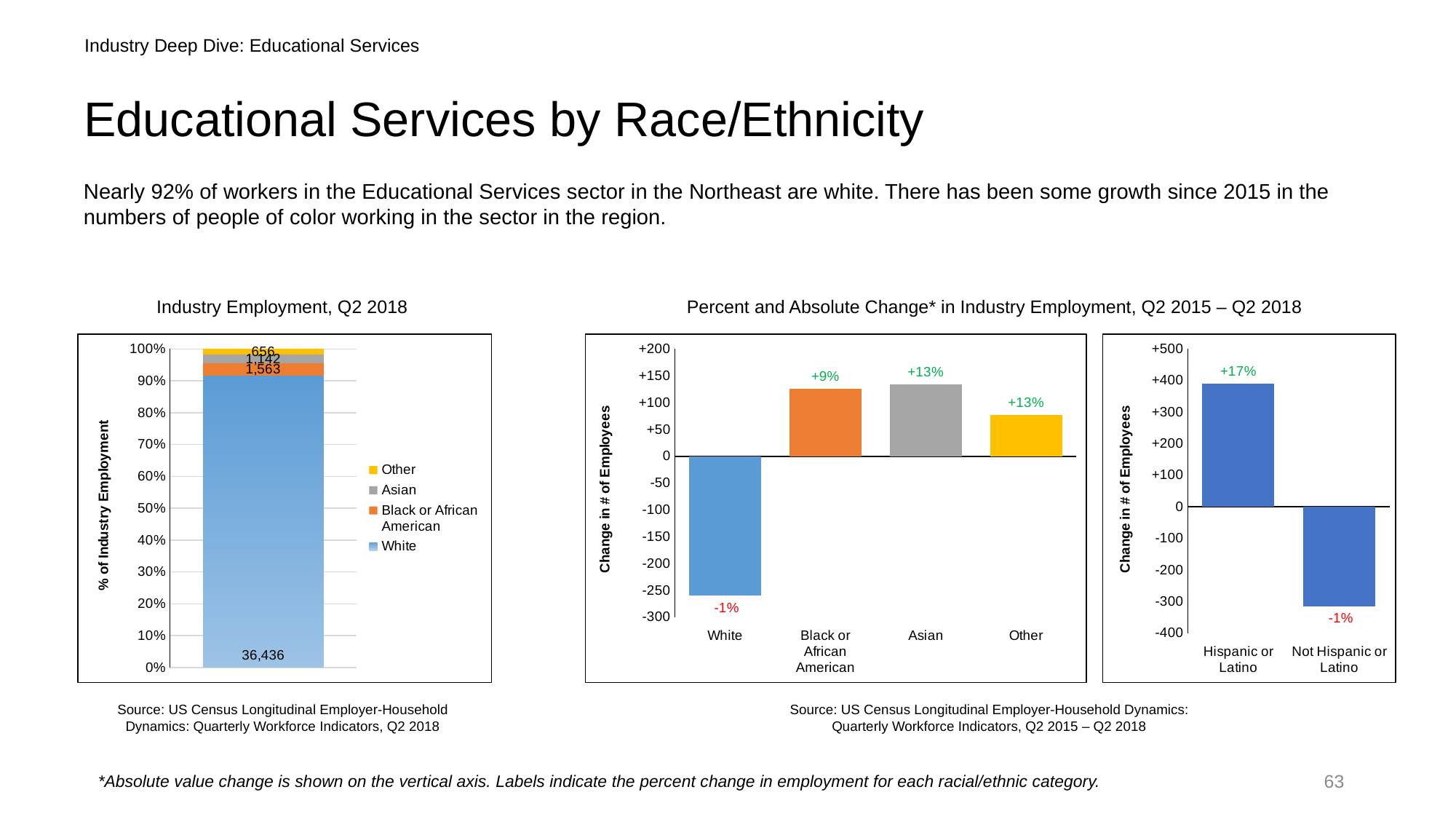
In the 'Industry Employment, Q2 2018' chart, what is the difference between the Black or African American value and the Asian value? 421 In the middle chart showing change in industry employment by race, how many categories are shown on the x axis? 4 In the middle chart showing change in industry employment by race, what percent change label is shown for Black or African American? +9% In the middle chart showing change in industry employment by race, what percent change label is shown for White? -1% In the right chart showing change in industry employment by Hispanic or Latino status, what percent change label is shown for Hispanic or Latino? +17% In the 'Industry Employment, Q2 2018' chart, which segment has the smallest value? Other In the middle chart showing change in industry employment by race, is the change in number of employees for White greater or less than -200? less In the right chart showing change in industry employment by Hispanic or Latino status, is the change in number of employees for Hispanic or Latino greater or less than +300? greater In the 'Industry Employment, Q2 2018' chart, how many series does the legend list? 4 In the 'Industry Employment, Q2 2018' chart, what is the data label for the Black or African American segment? 1,563 In the 'Industry Employment, Q2 2018' chart, what is the data label for the Asian segment? 1,142 In the 'Industry Employment, Q2 2018' chart, what is the data label for the White segment? 36,436